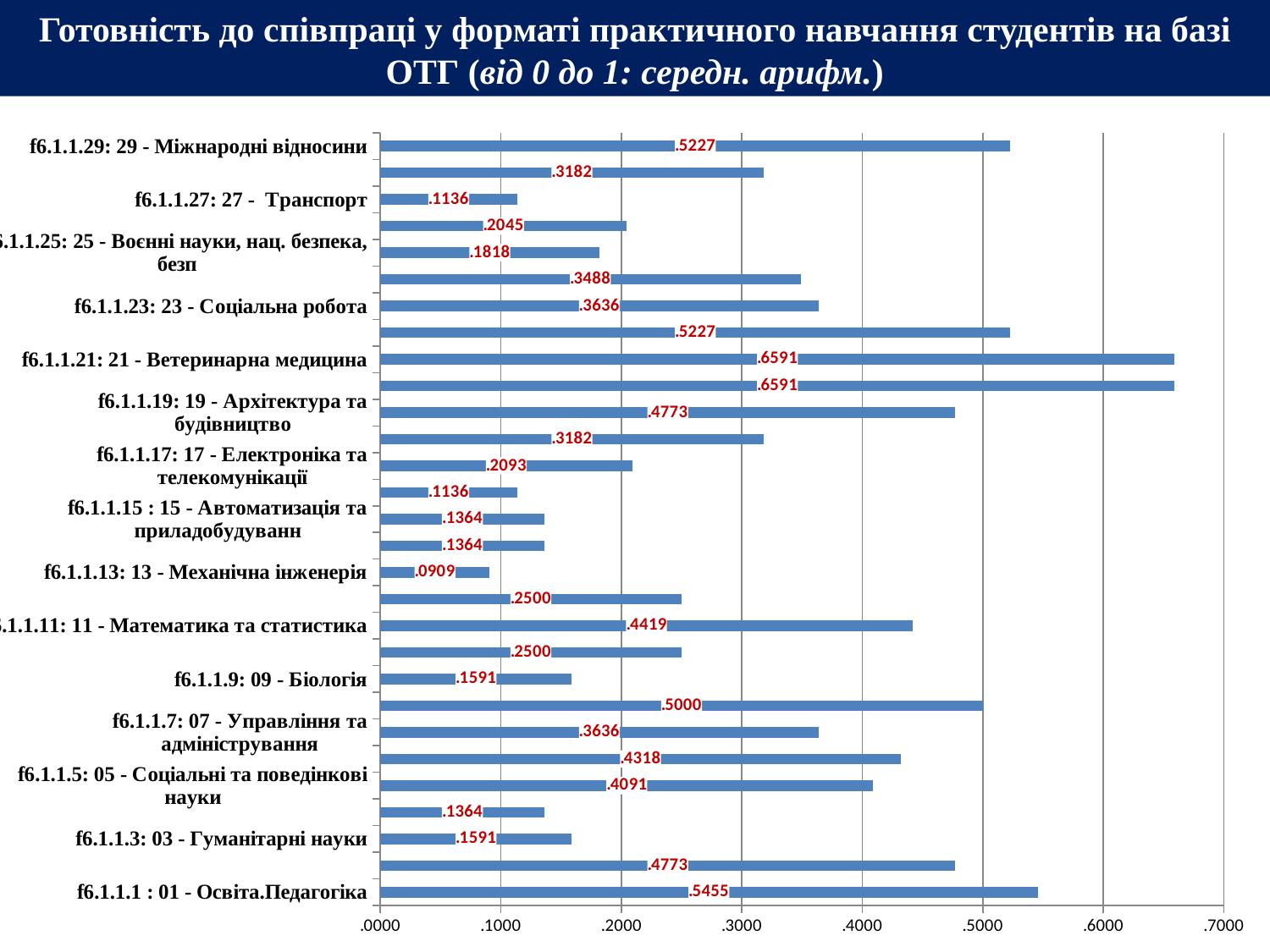
What is the difference between the values for f6.1.1.29: 29 - Міжнародні відносини and f6.1.1.23: 23 - Соціальна робота? .1591 Which is larger, the value for f6.1.1.9: 09 - Біологія or the value for f6.1.1.25: 25 - Воєнні науки, нац. безпека, безп? f6.1.1.25: 25 - Воєнні науки, нац. безпека, безп What kind of chart is shown on the slide? Bar chart What is the value for f6.1.1.27: 27 - Транспорт? .1136 Which labelled category has the lowest value? f6.1.1.13: 13 - Механічна інженерія What is the value for f6.1.1.1 : 01 - Освіта.Педагогіка? .5455 How many bars are plotted in the chart? 29 What is the maximum value shown on the horizontal axis? .7000 What is the value for f6.1.1.7: 07 - Управління та адміністрування? .3636 What is the value for f6.1.1.11: 11 - Математика та статистика? .4419 Is the value for f6.1.1.19: 19 - Архітектура та будівництво greater or less than .4000? greater What is the value for f6.1.1.21: 21 - Ветеринарна медицина? .6591